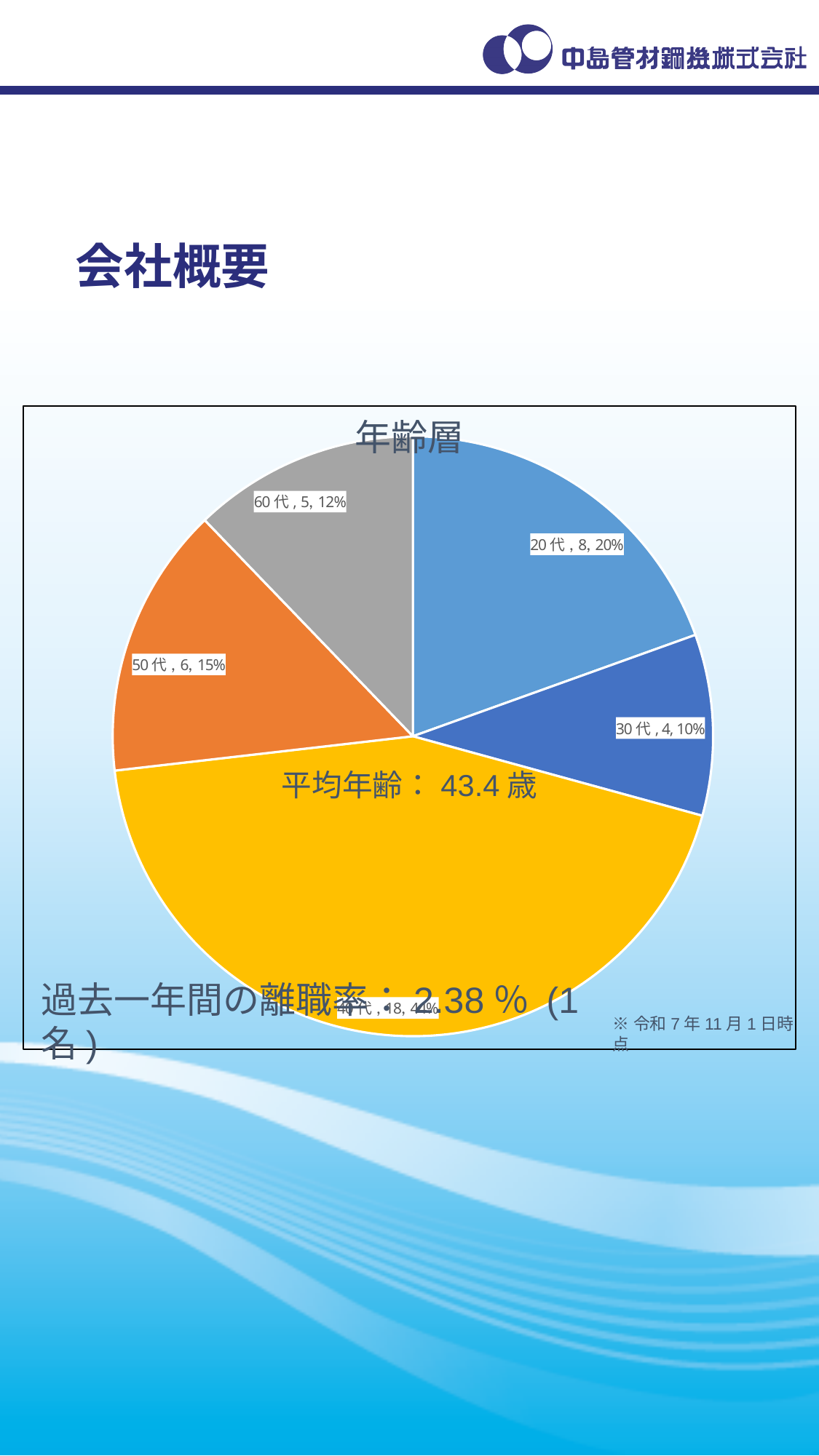
How many slices does the pie chart have? 5 How many people are in the 30代 slice? 4 What percentage share does the 60代 slice have? 12% How many people are in the 20代 slice? 8 What percentage share does the 50代 slice have? 15% Which slice is the smallest in the pie chart? 30代 What kind of chart is shown on the slide? pie chart What percentage share does the 20代 slice have? 20% What is the difference in number of people between the 20代 and 30代 slices? 4 What is the title of the chart? 年齢層 How many people are in the 60代 slice? 5 Which has more people, 20代 or 30代? 20代